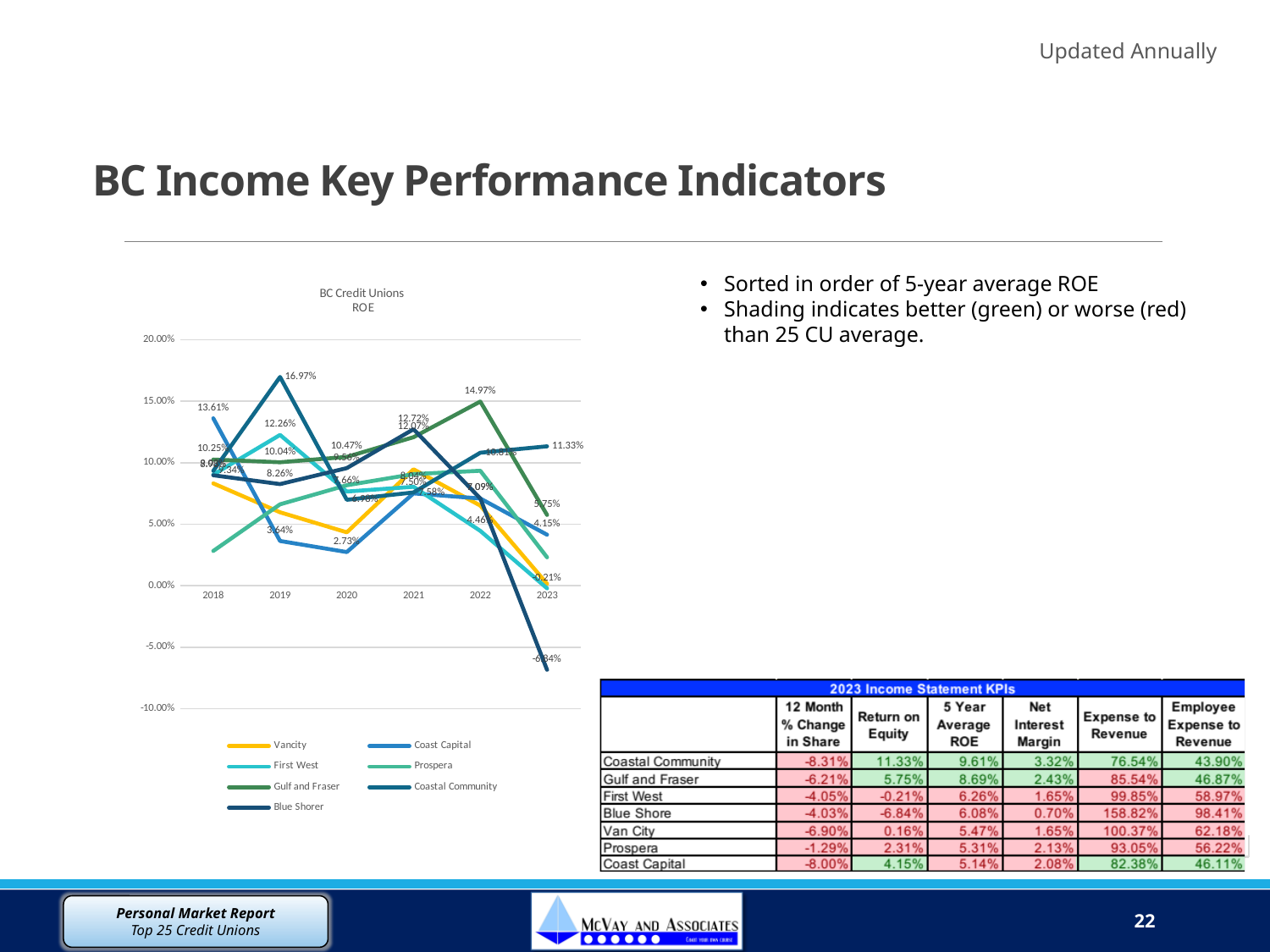
What is the highest ROE value labelled for 2022 on the BC Credit Unions ROE chart? 14.97% What is the lowest ROE value labelled on the BC Credit Unions ROE chart? -6.84% On the BC Credit Unions ROE chart, what is the difference between the 2019 peak of 16.97% and the 2022 peak of 14.97%? 2.00% What is the maximum value shown on the y axis of the BC Credit Unions ROE chart? 20.00% In which year does the highest labelled ROE value (16.97%) occur on the BC Credit Unions ROE chart? 2019 What kind of chart is the BC Credit Unions ROE chart? line chart On the BC Credit Unions ROE chart, is the 2019 peak value greater or less than 15.00%? greater On the BC Credit Unions ROE chart, is the lowest 2023 value greater or less than -5.00%? less How many series does the legend of the BC Credit Unions ROE chart list? 7 How many years are shown on the x axis of the BC Credit Unions ROE chart? 6 What is the highest ROE value labelled on the BC Credit Unions ROE chart? 16.97% What is the highest ROE value labelled for 2023 on the BC Credit Unions ROE chart? 11.33%